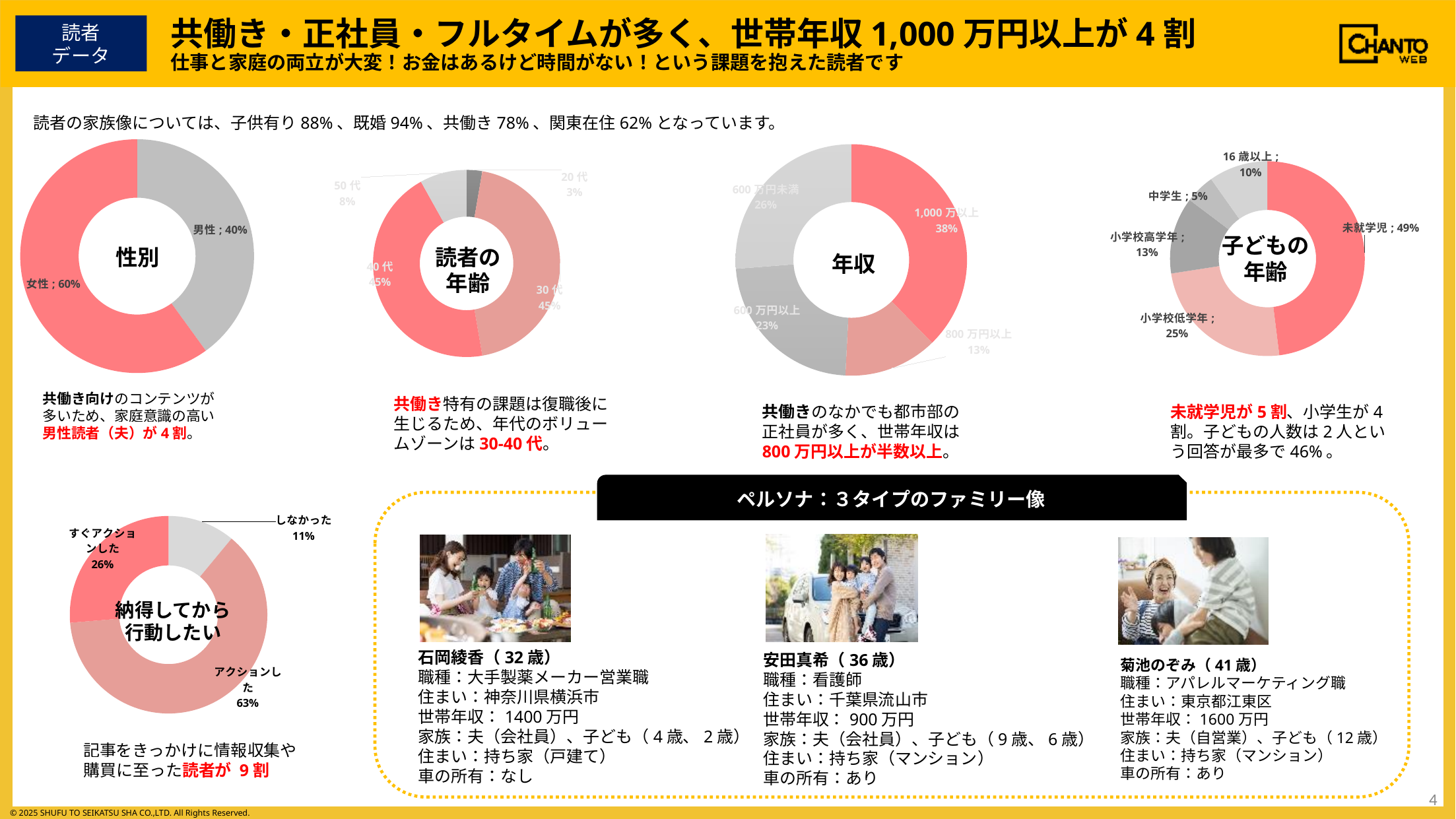
In the 子どもの年齢 chart, how many categories are shown? 5 In the 子どもの年齢 chart, what percentage is 未就学児? 49% What kind of chart is the 性別 chart? Donut (pie) chart In the 年収 chart, what is the difference between 600万円未満 and 600万円以上? 3% In the 年収 chart, which category has the smallest share? 800万円以上 In the 納得してから行動したい chart, what is the combined share of すぐアクションした and アクションした? 89% In the 性別 chart, what percentage is 女性? 60% In the 子どもの年齢 chart, which is larger, 小学校低学年 or 16歳以上? 小学校低学年 In the 納得してから行動したい chart, what percentage is アクションした? 63% In the 性別 chart, what percentage is 男性? 40% In the 子どもの年齢 chart, which category has the smallest share? 中学生 In the 年収 chart, what percentage is 1,000万以上? 38%